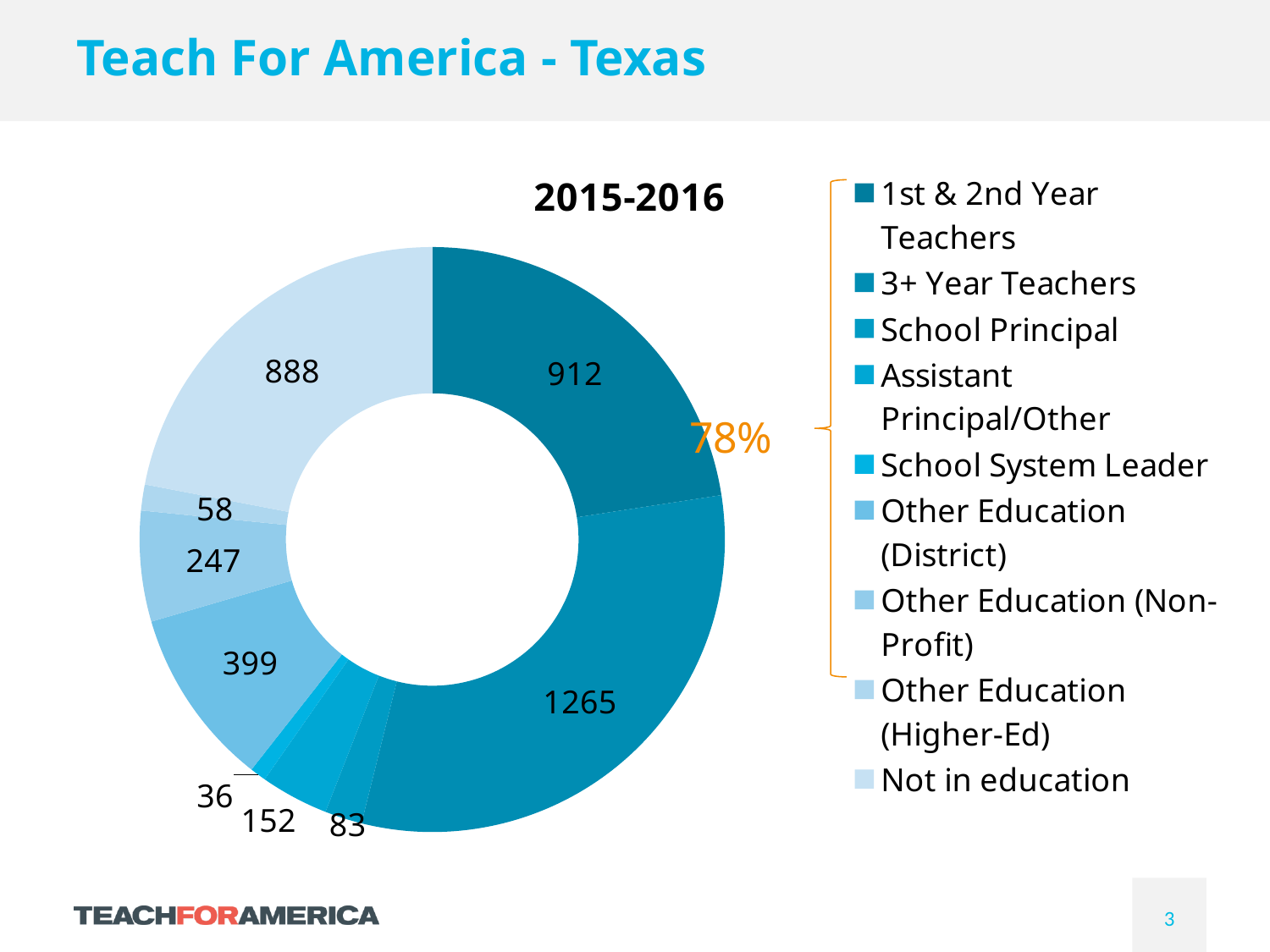
What is the value for Other Education (District)? 399 What is the difference between the values for 3+ Year Teachers and 1st & 2nd Year Teachers? 353 Which is larger, the value for Other Education (Non-Profit) or the value for Assistant Principal/Other? Other Education (Non-Profit) What is the value for Not in education? 888 What is the value for 1st & 2nd Year Teachers? 912 What is the title of the chart? 2015-2016 What percentage is annotated next to the bracket grouping the education-related categories? 78% Which category has the smallest value? School System Leader What is the value for 3+ Year Teachers? 1265 How many categories does the chart's legend list? 9 What kind of chart is shown on the slide? Doughnut (pie) chart Which category has the largest value? 3+ Year Teachers